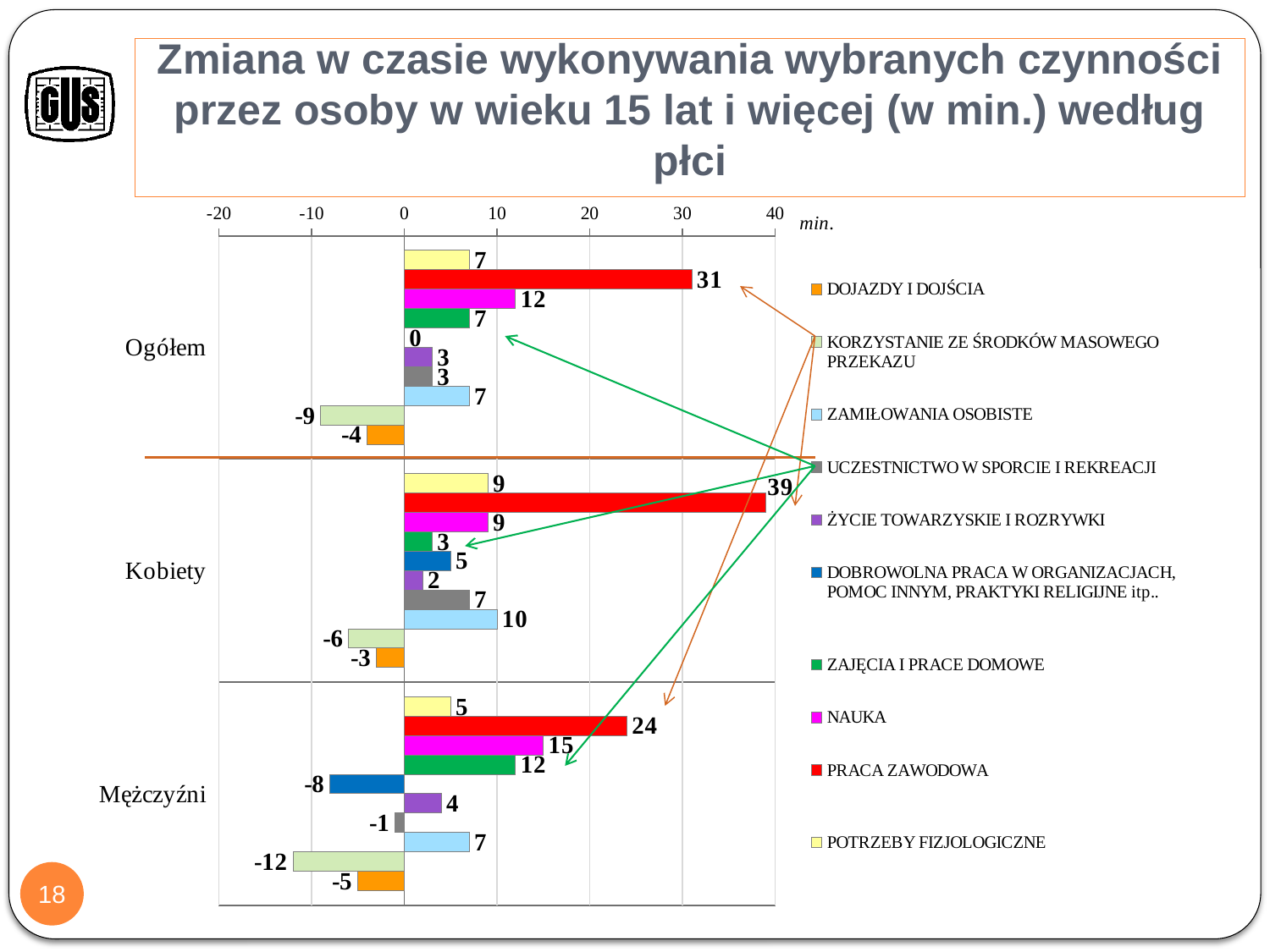
How many series does the legend list? 10 Which activity has the lowest value in the Mężczyźni group? KORZYSTANIE ZE ŚRODKÓW MASOWEGO PRZEKAZU What kind of chart is shown on the slide? bar chart What is the difference between the PRACA ZAWODOWA values for Kobiety and Mężczyźni? 15 Which group has the larger value for ZAJĘCIA I PRACE DOMOWE, Kobiety or Mężczyźni? Mężczyźni Which activity has the highest value in the Ogółem group? PRACA ZAWODOWA What is the value for NAUKA in the Mężczyźni group? 15 What is the value for DOBROWOLNA PRACA W ORGANIZACJACH, POMOC INNYM, PRAKTYKI RELIGIJNE itp. in the Ogółem group? 0 What is the value for PRACA ZAWODOWA in the Kobiety group? 39 What is the value for DOJAZDY I DOJŚCIA in the Mężczyźni group? -5 How many groups (categories) are shown on the vertical axis of the chart? 3 What unit is indicated at the end of the horizontal axis? min.